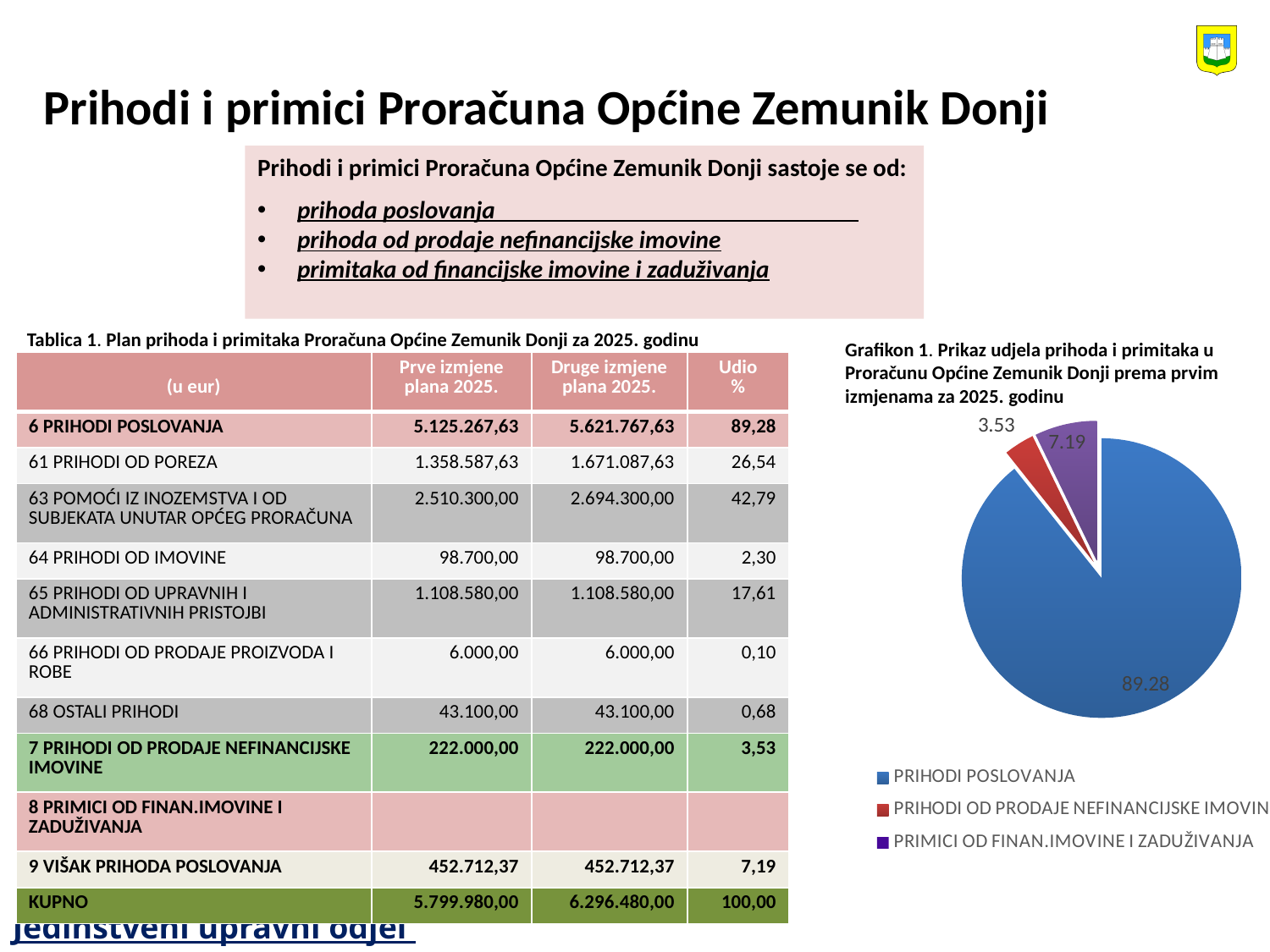
How many slices does the pie chart have? 3 What value is shown for the PRIHODI OD PRODAJE NEFINANCIJSKE IMOVINE slice in the pie chart? 3.53 What is the title of the chart on the slide? Grafikon 1. Prikaz udjela prihoda i primitaka u Proračunu Općine Zemunik Donji prema prvim izmjenama za 2025. godinu What kind of chart is Grafikon 1 on the slide? pie chart Which category has the largest slice in the pie chart? PRIHODI POSLOVANJA How many entries does the pie chart's legend list? 3 What colour is the PRIHODI POSLOVANJA slice in the pie chart? blue Which category has the smallest slice in the pie chart? PRIHODI OD PRODAJE NEFINANCIJSKE IMOVINE What value is shown for PRIHODI POSLOVANJA in the pie chart? 89.28